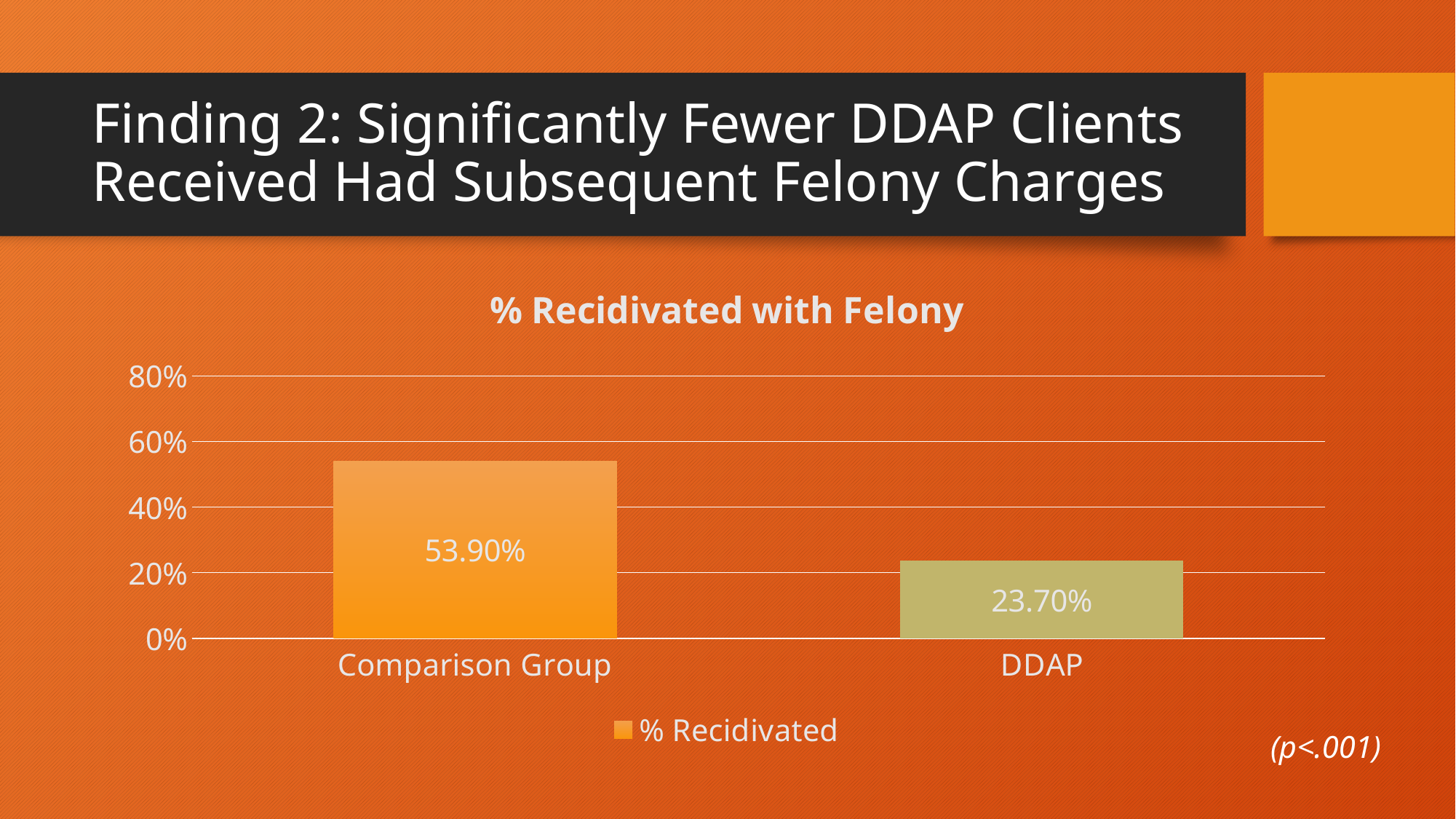
Is the value for DDAP greater or less than 40%? less What is the value for DDAP? 23.70% What kind of chart is shown on the slide? bar chart Is the value for the Comparison Group greater or less than 40%? greater What is the title of the chart? % Recidivated with Felony What is the difference between the Comparison Group and DDAP values? 30.20% How many categories are shown on the chart? 2 What is the value for the Comparison Group? 53.90% Which is larger, the value for the Comparison Group or the value for DDAP? Comparison Group How many series does the legend list? 1 Which category has the highest value? Comparison Group Which category has the lowest value? DDAP